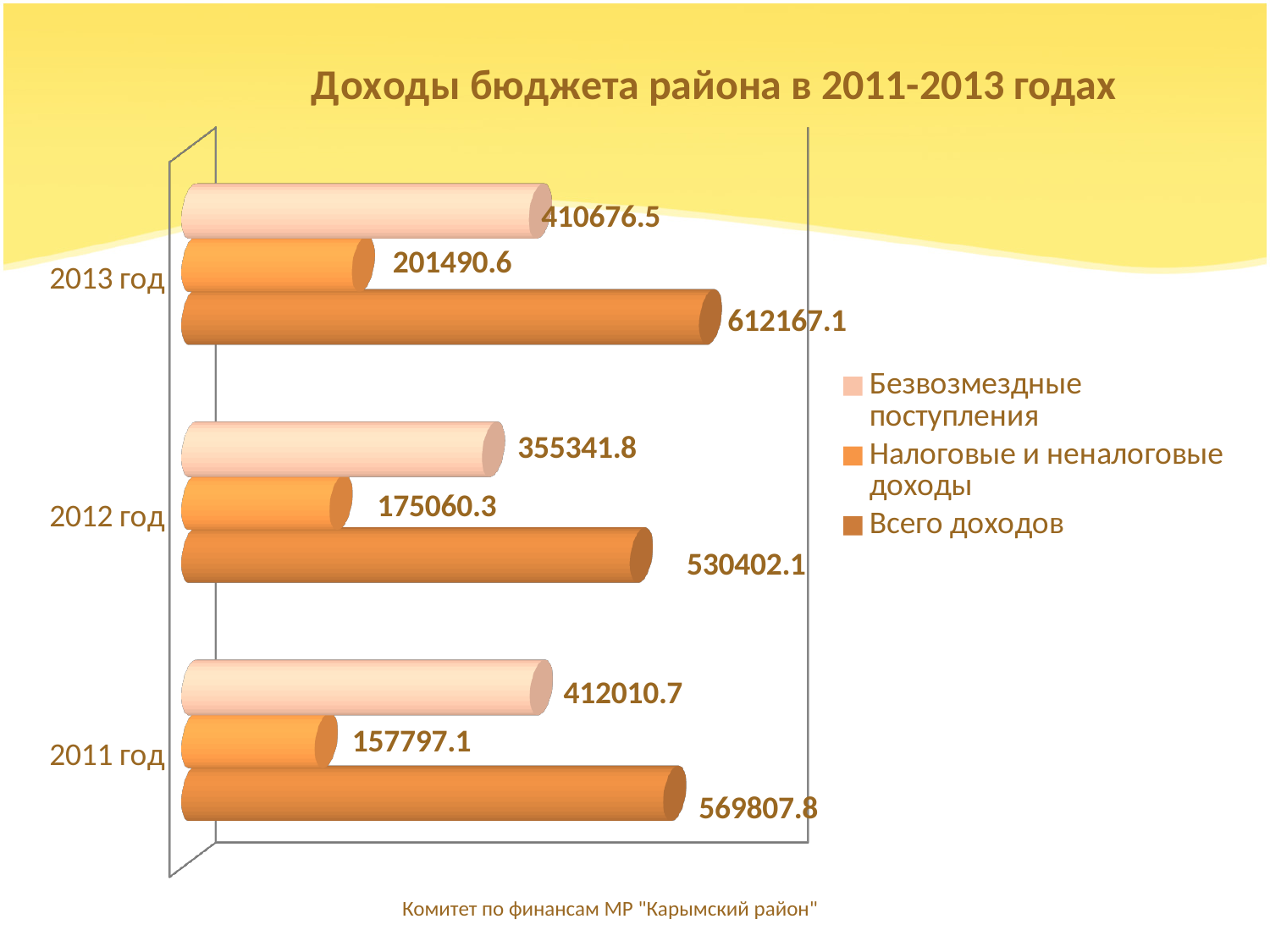
What is the difference between Всего доходов in 2013 год and in 2012 год? 81765.0 What kind of chart is shown on the slide? Bar chart How many years are shown on the chart? 3 Do the values of Налоговые и неналоговые доходы rise or fall from 2011 год to 2013 год? Rise What is the value of Налоговые и неналоговые доходы for 2011 год? 157797.1 In which year is Всего доходов the highest? 2013 год What is the difference between Налоговые и неналоговые доходы in 2013 год and in 2012 год? 26430.3 What is the value of Безвозмездные поступления for 2012 год? 355341.8 Which is larger: Безвозмездные поступления in 2012 год or in 2013 год? 2013 год What is the value of Всего доходов for 2013 год? 612167.1 In which year is Налоговые и неналоговые доходы the lowest? 2011 год How many series does the legend list? 3